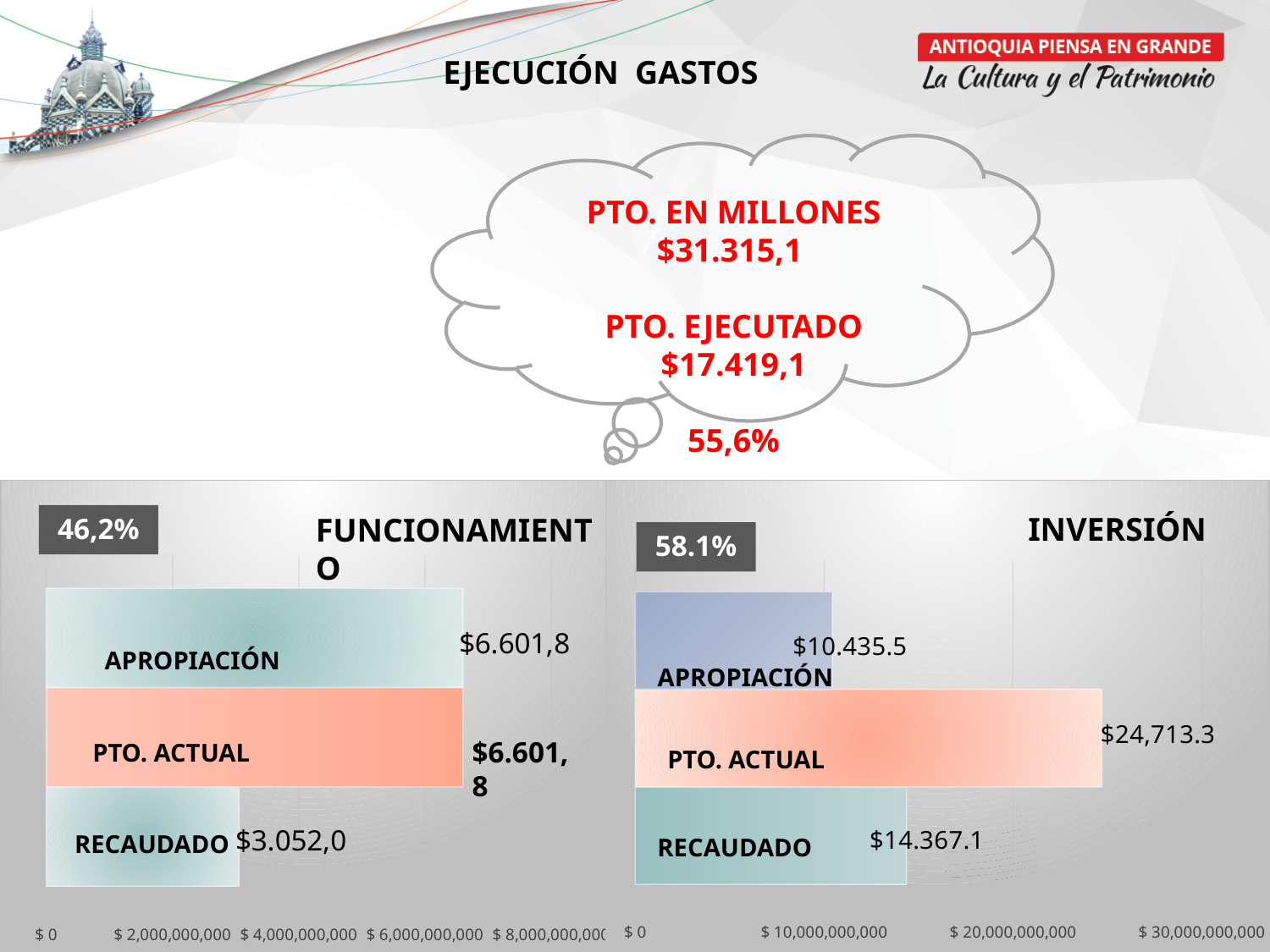
In the INVERSIÓN chart, what is the value for APROPIACIÓN? $10.435.5 How many bars are shown in the FUNCIONAMIENTO chart? 3 In the FUNCIONAMIENTO chart, what is the value for APROPIACIÓN? $6.601,8 In the FUNCIONAMIENTO chart, what is the difference between PTO. ACTUAL and RECAUDADO? $3.549,8 In the INVERSIÓN chart, which category has the highest value? PTO. ACTUAL In the INVERSIÓN chart, what is the value for PTO. ACTUAL? $24,713.3 In the INVERSIÓN chart, what is the value for RECAUDADO? $14.367.1 In the FUNCIONAMIENTO chart, which category has the lowest value? RECAUDADO In the INVERSIÓN chart, is the bar for PTO. ACTUAL greater or less than $20,000,000,000? greater In the INVERSIÓN chart, which is larger, APROPIACIÓN or RECAUDADO? RECAUDADO What type of chart is the INVERSIÓN chart? Bar chart In the FUNCIONAMIENTO chart, what is the value for RECAUDADO? $3.052,0